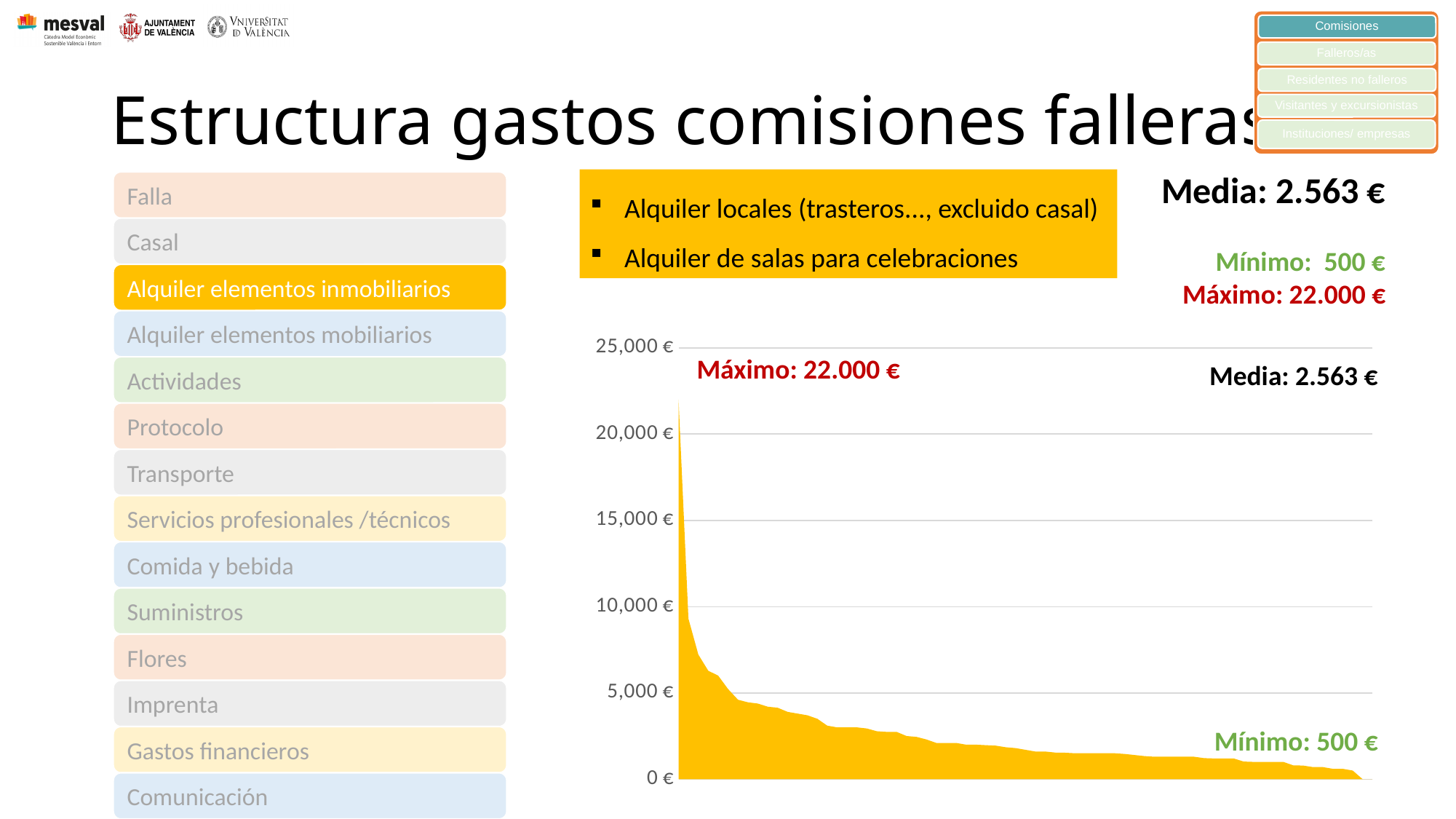
What is the minimum value annotated on the chart? 500 € Is the annotated mean value (Media) greater or less than 5,000 €? less What is the highest tick label shown on the y axis of the chart? 25,000 € Which is larger, the annotated maximum or the annotated mean (Media)? the maximum (22.000 €) What kind of chart is shown on the slide? area chart What is the maximum value annotated on the chart? 22.000 € What is the mean (Media) value annotated on the chart? 2.563 € Do the plotted values rise or fall from left to right along the x axis? fall Is the highest point of the chart greater or less than 20,000 €? greater What is the difference between the annotated maximum and minimum values on the chart? 21.500 € What colour is the filled area of the chart? yellow/orange